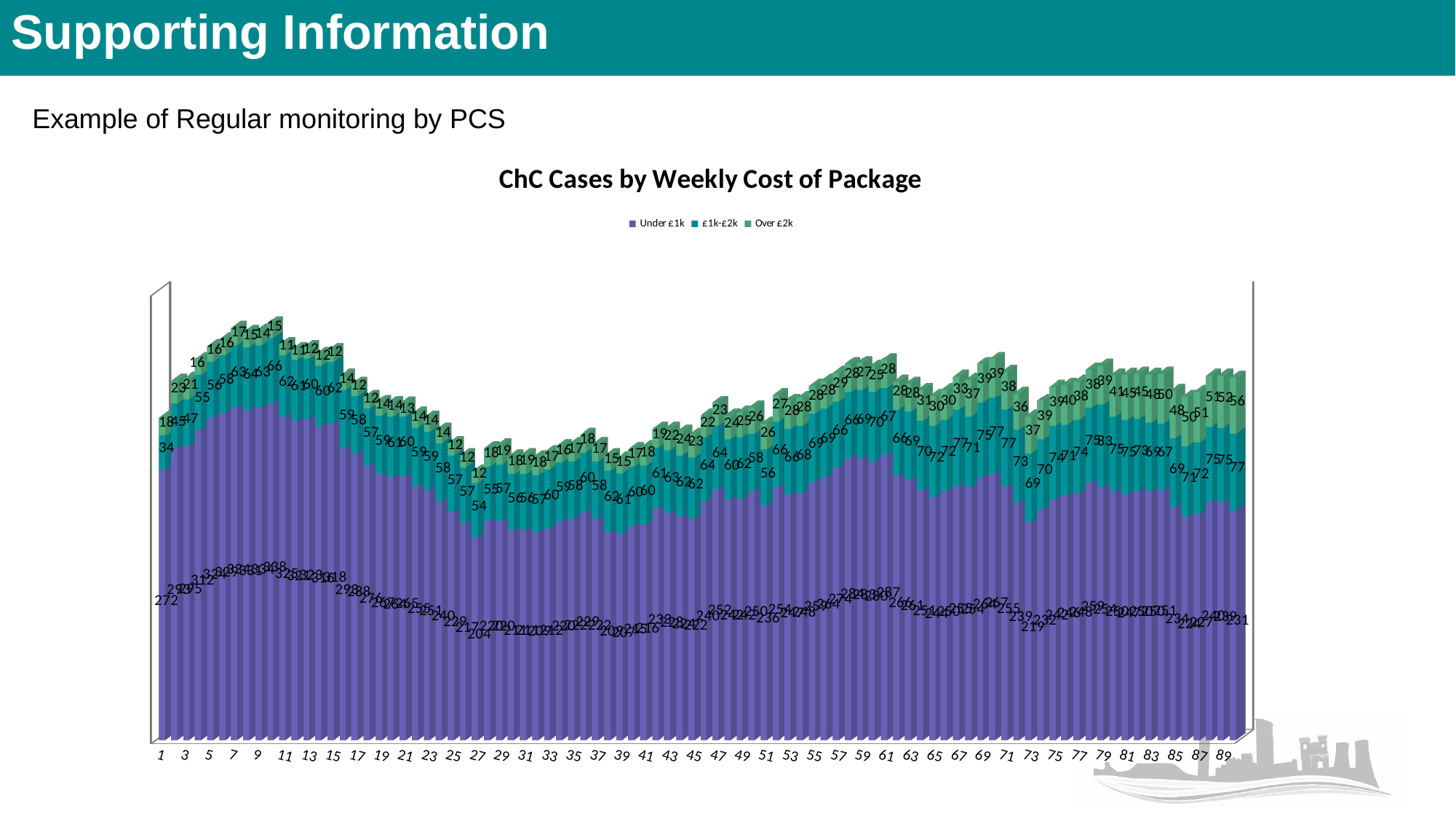
What is the Under £1k value for category 1? 272 Is the £1k-£2k value larger for category 1 or category 27? Category 27 What is the £1k-£2k value for category 1? 34 What is the difference between the Under £1k values for category 1 and category 27? 68 What kind of chart is shown on the slide? Stacked bar chart What is the total of the stacked bar for category 1? 324 How many series does the chart's legend list? 3 What is the title of the chart? ChC Cases by Weekly Cost of Package Which series are listed in the chart's legend? Under £1k, £1k-£2k, Over £2k What is the Under £1k value for category 27? 204 What is the Over £2k value for category 1? 18 Which category has the lowest Under £1k value? 27